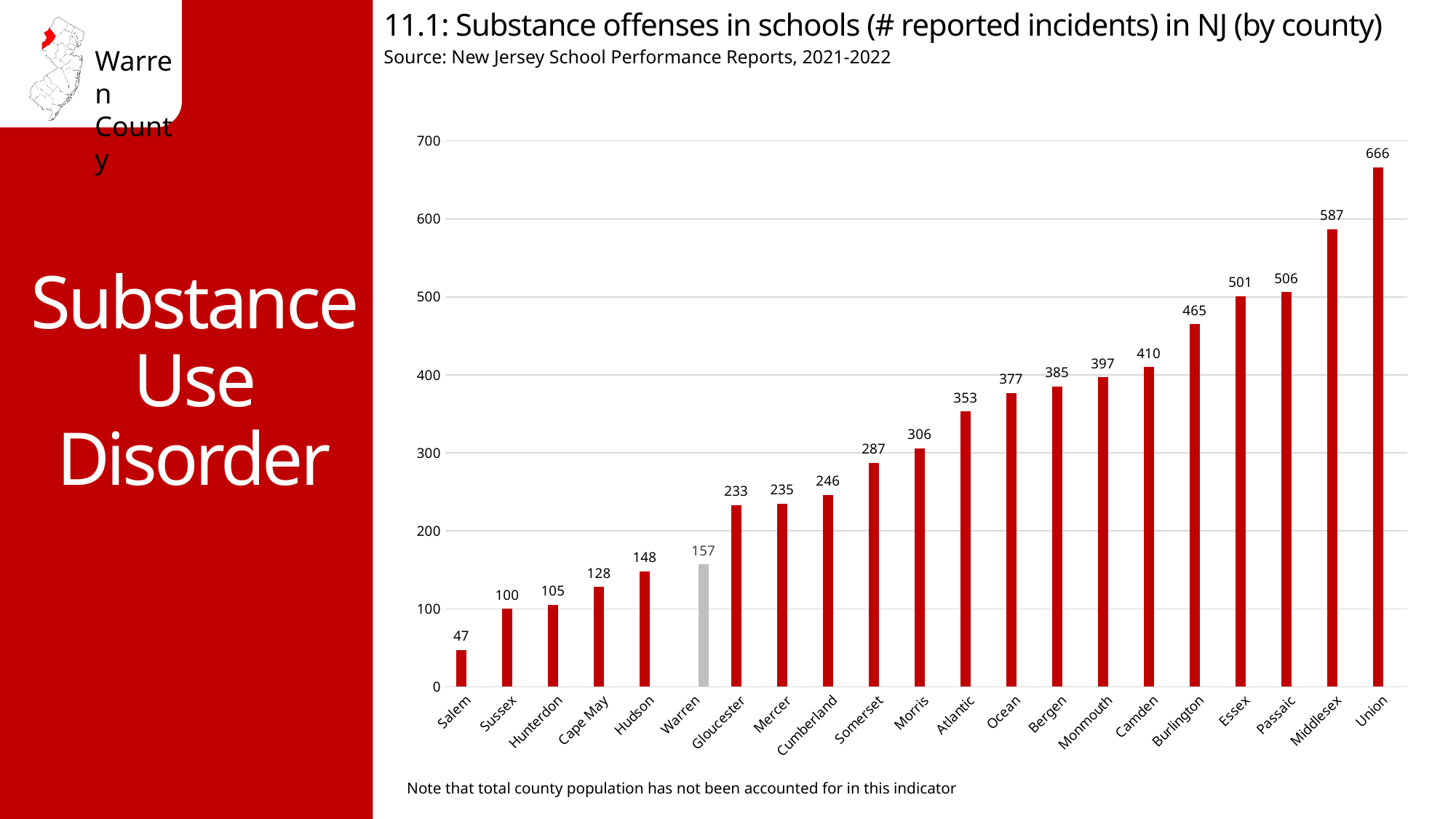
What kind of chart is shown on the slide? Bar chart What is the difference between the values for Union and Salem? 619 What is the value shown for Middlesex County? 587 Is the value for Burlington greater or less than 500? less Which has a higher value, Camden or Bergen? Camden Which county's bar is shown in gray instead of red? Warren Which county has the highest number of reported incidents? Union Do the values rise or fall moving from left to right along the x axis? Rise What is the number of reported substance offense incidents in schools for Warren County? 157 How many more incidents does Gloucester have than Warren? 76 Which county has the lowest number of reported incidents? Salem How many counties are shown on the chart? 21